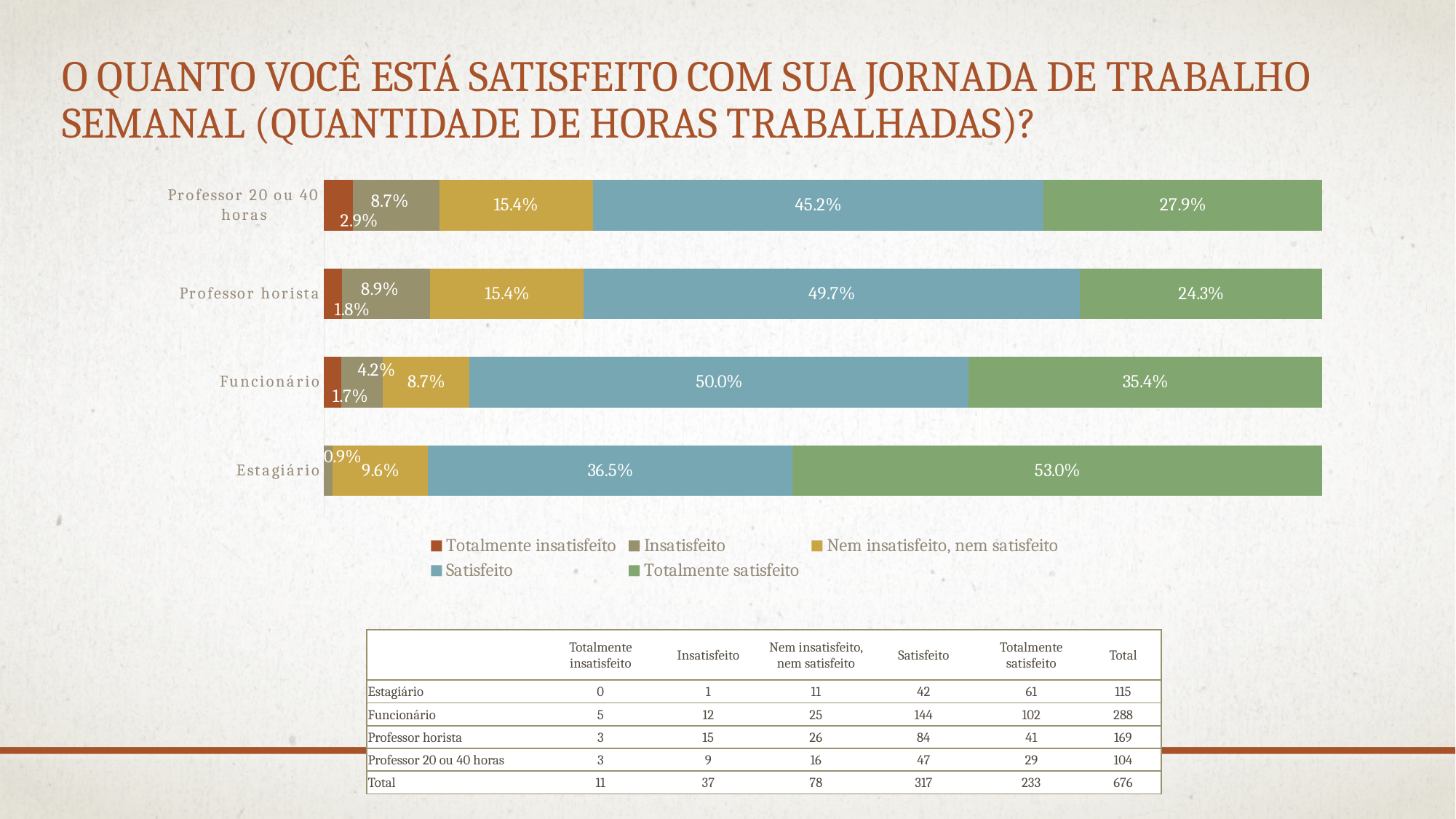
What is the 'Satisfeito' percentage for Funcionário? 50.0% How many categories (job groups) are plotted in the chart? 4 What kind of chart is shown on the slide? stacked bar chart Which is larger: the 'Insatisfeito' percentage for Professor horista or for Funcionário? Professor horista Which category has the lowest 'Satisfeito' percentage? Estagiário What is the 'Nem insatisfeito, nem satisfeito' percentage for Professor horista? 15.4% What is the 'Totalmente insatisfeito' percentage for Professor 20 ou 40 horas? 2.9% Which colour represents the 'Satisfeito' series in the chart? blue How many series does the chart legend list? 5 Which category has the highest 'Totalmente satisfeito' percentage? Estagiário What is the 'Totalmente satisfeito' percentage for Estagiário? 53.0% What is the difference between the 'Totalmente satisfeito' percentages of Funcionário and Professor horista? 11.1%